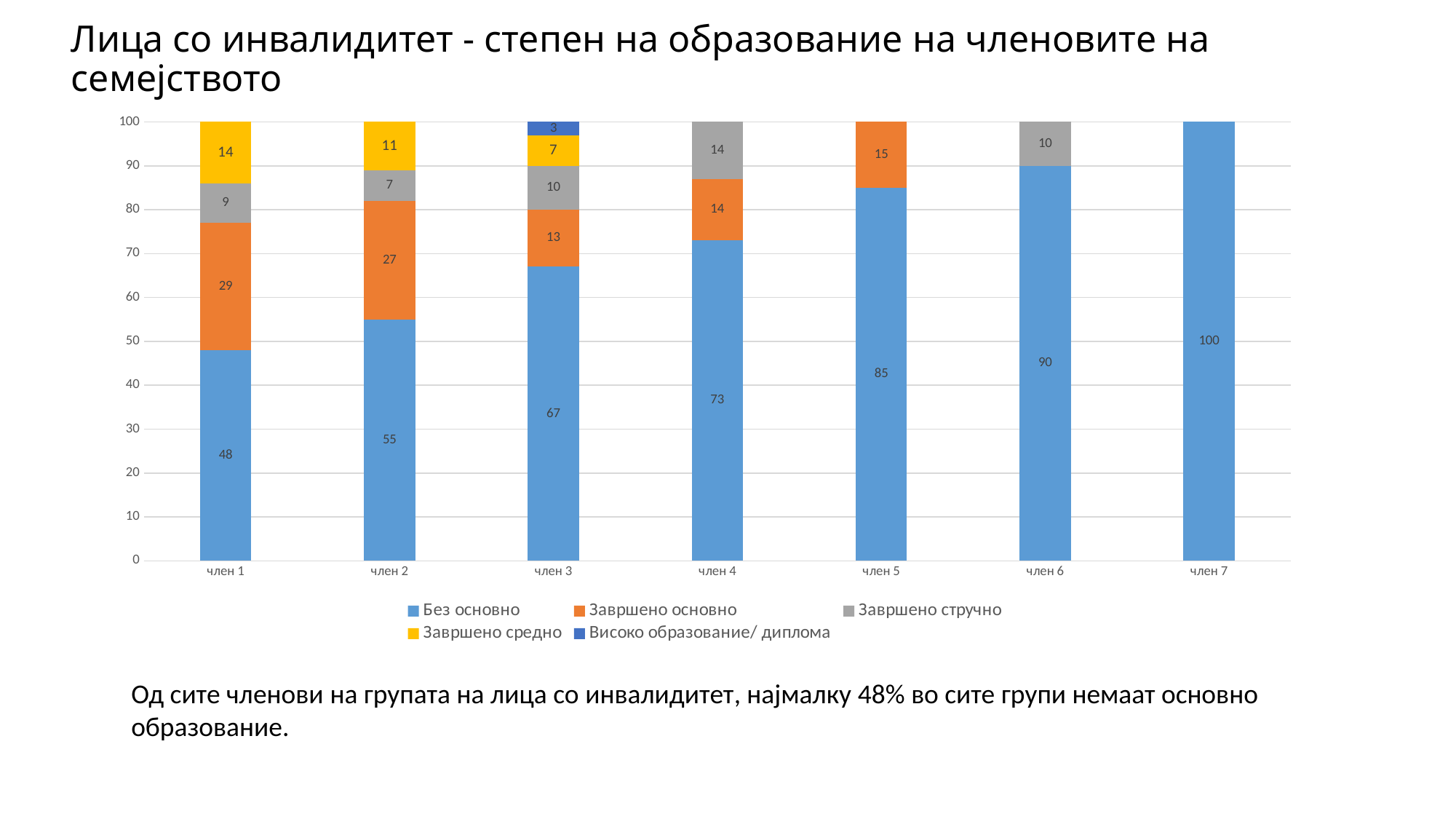
Which has the larger Завршено основно value, член 1 or член 2? член 1 How many categories are shown on the x axis? 7 What is the value of Завршено средно for член 1? 14 What is the difference between the Без основно values for член 6 and член 5? 5 What is the value of Завршено основно for член 2? 27 Does the Без основно value rise or fall from член 1 to член 7? Rises Which category has the lowest value for Без основно? член 1 What is the value of Без основно for член 3? 67 What kind of chart is shown on the slide? Stacked bar chart How many series does the legend list? 5 Which category has the highest value for Без основно? член 7 What is the value of Високо образование/ диплома for член 3? 3